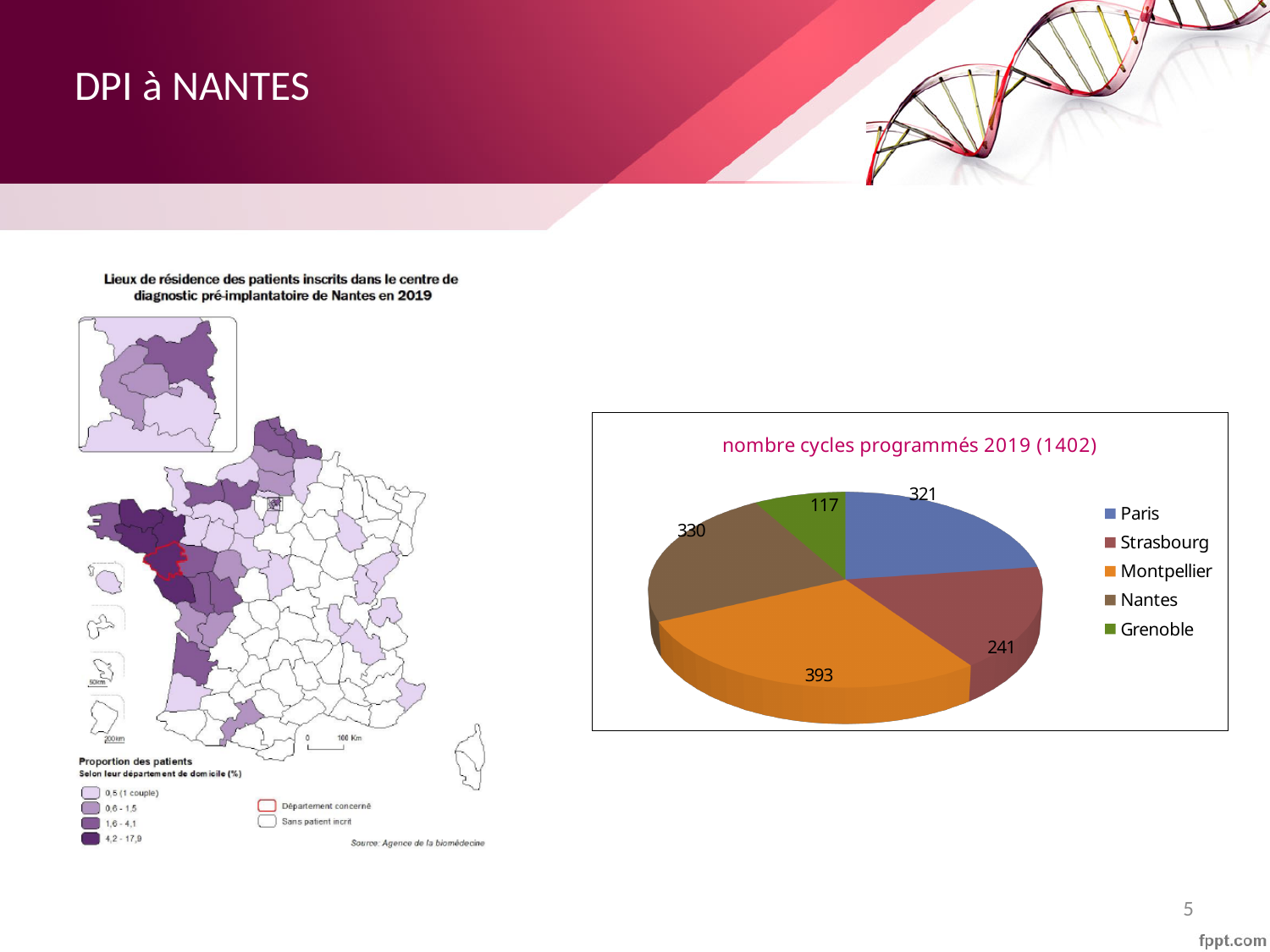
What is the value for Grenoble in the pie chart? 117 What kind of chart is shown on the slide? pie chart What is the difference between the values for Montpellier and Strasbourg in the pie chart? 152 How many cycles were programmed in Paris according to the pie chart? 321 Which centre has the largest slice in the pie chart? Montpellier Which is larger in the pie chart, the value for Nantes or the value for Paris? Nantes What is the title of the pie chart? nombre cycles programmés 2019 (1402) How many centres does the legend of the pie chart list? 5 What is the total number of cycles shown in the pie chart title? 1402 What is the value for Nantes in the pie chart? 330 Which centre has the smallest slice in the pie chart? Grenoble What is the value for Montpellier in the pie chart? 393